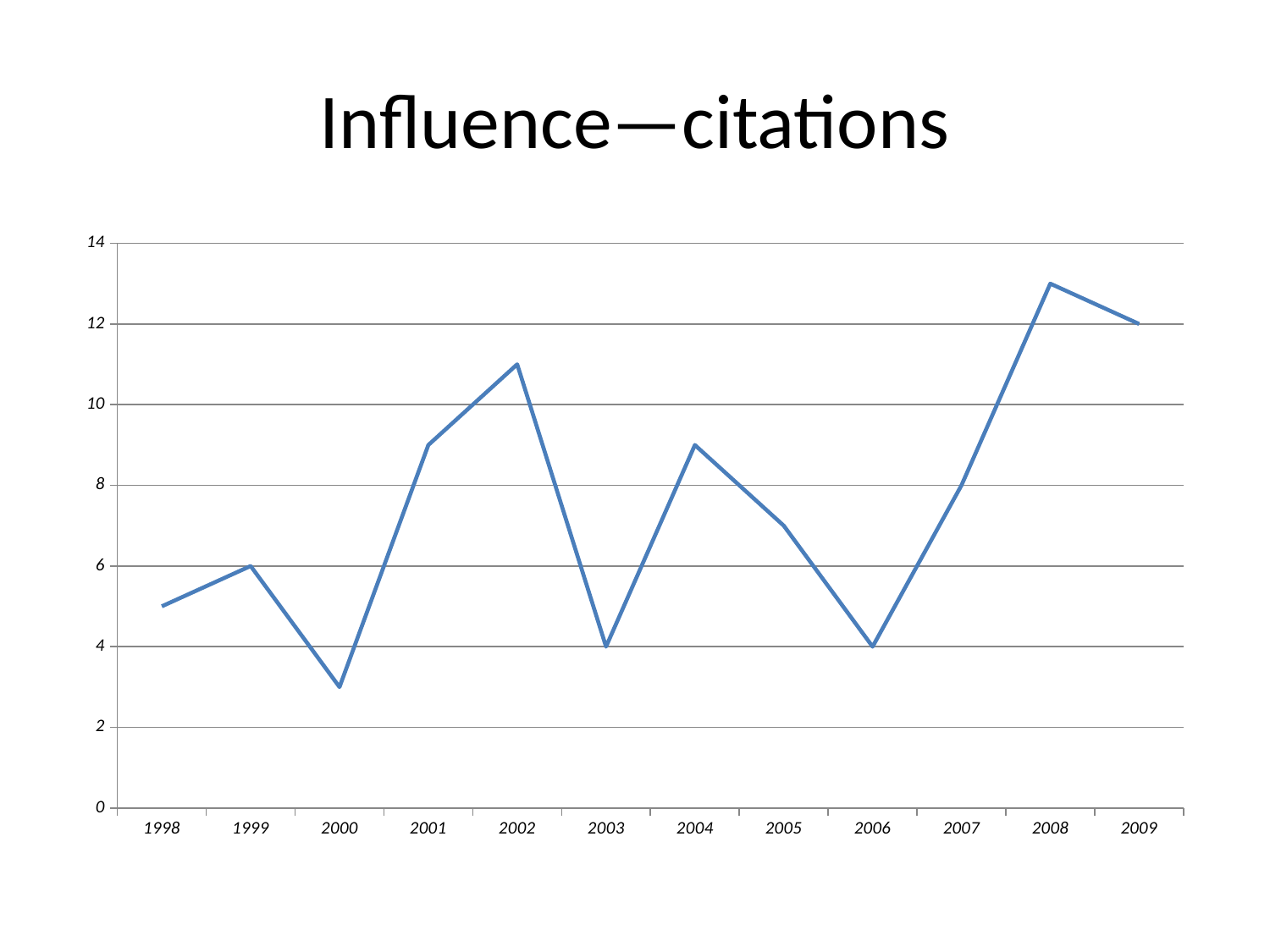
What is the value for 2009? 12 Do the values rise or fall from 2006 to 2008? rise How many years are plotted on the x axis? 12 Which year has the larger value, 2002 or 2004? 2002 Which year has the lowest value? 2000 What is the difference between the values for 2009 and 2003? 8 What is the value for 1999? 6 What is the title of the chart? Influence—citations Which year has the highest value? 2008 What type of chart is shown on the slide? line chart What is the value for 2007? 8 Is the value for 2002 greater or less than 10? greater